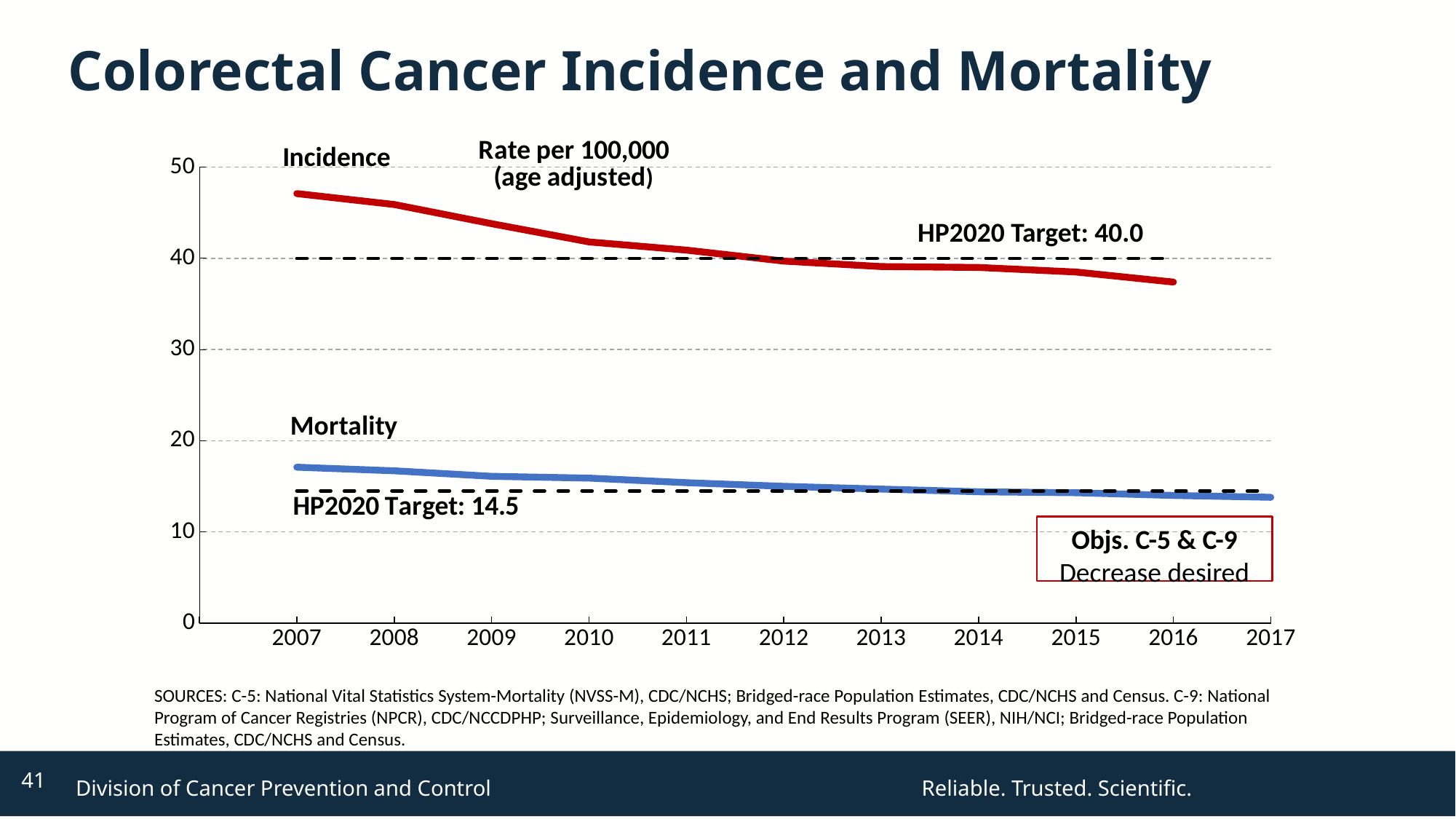
How many year labels are shown on the x axis? 11 What unit is the rate on the chart expressed in, according to the label above the chart? Rate per 100,000 (age adjusted) Is the Incidence value for 2007 greater or less than 40? greater Which is larger in 2012, the Incidence value or the Mortality value? Incidence What is the HP2020 target for colorectal cancer mortality shown on the chart? 14.5 Is the Incidence value for 2016 greater or less than 40? less Does the Incidence line rise or fall from 2007 to 2016? fall What is the HP2020 target for colorectal cancer incidence shown on the chart? 40.0 Is the Mortality value for 2007 greater or less than 20? less What kind of chart is shown on the slide? line chart Which year has the highest Incidence value? 2007 Does the Mortality line rise or fall from 2007 to 2017? fall